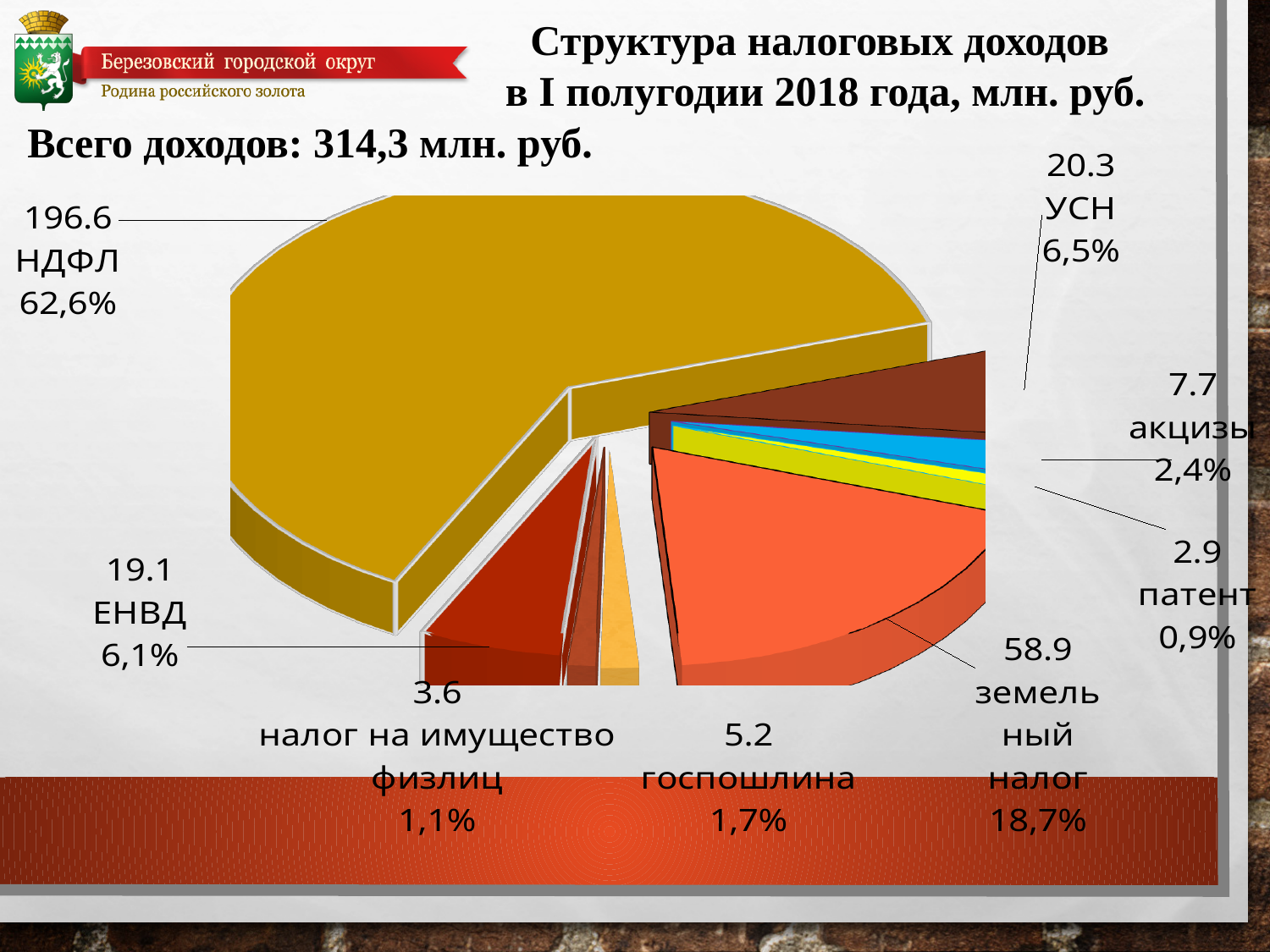
What is the value for НДФЛ? 196.6 What is the difference between the values for НДФЛ and земельный налог? 137.7 What is the value for УСН? 20.3 What is the chart's title? Структура налоговых доходов в I полугодии 2018 года, млн. руб. What share of the pie does ЕНВД represent? 6,1% What share of the pie does акцизы represent? 2,4% Which category has the smallest slice? патент Which is larger, the value for УСН or the value for ЕНВД? УСН Which category has the largest slice? НДФЛ What kind of chart is shown on the slide? pie chart How many slices does the pie chart have? 8 What is the value for земельный налог? 58.9